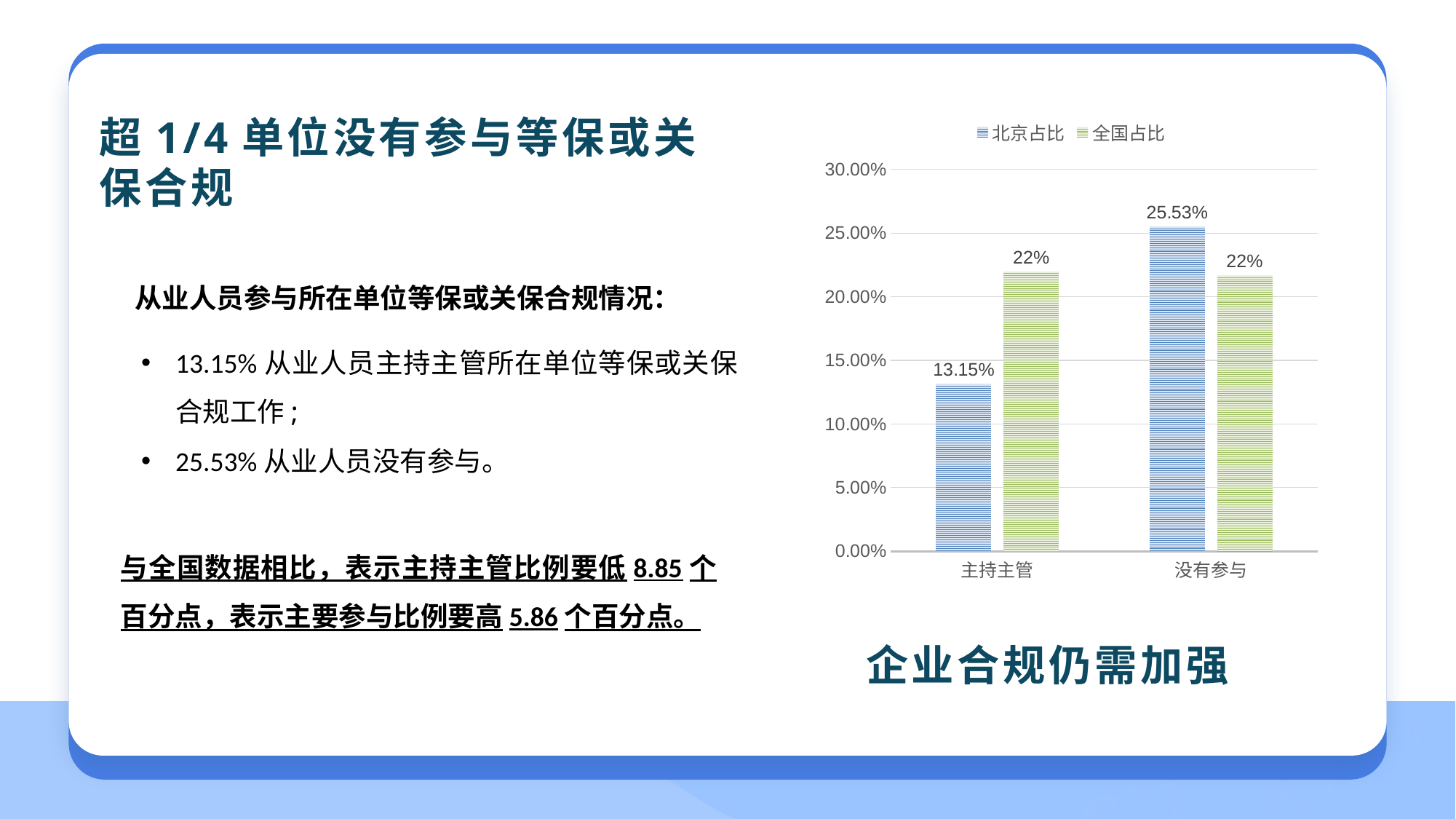
What kind of chart is shown on the slide? bar chart How many series does the legend list? 2 Which category has the lowest 北京占比 value? 主持主管 Which category has the highest 北京占比 value? 没有参与 What is the 全国占比 value for 主持主管? 22% What is the difference between the 北京占比 and 全国占比 values for 没有参与? 3.53 percentage points For 没有参与, which is larger: 北京占比 or 全国占比? 北京占比 Is the 北京占比 value for 主持主管 greater or less than 15.00%? less What is the 北京占比 value for 主持主管? 13.15% What is the difference between the 全国占比 and 北京占比 values for 主持主管? 8.85 percentage points What is the 全国占比 value for 没有参与? 22% What is the 北京占比 value for 没有参与? 25.53%